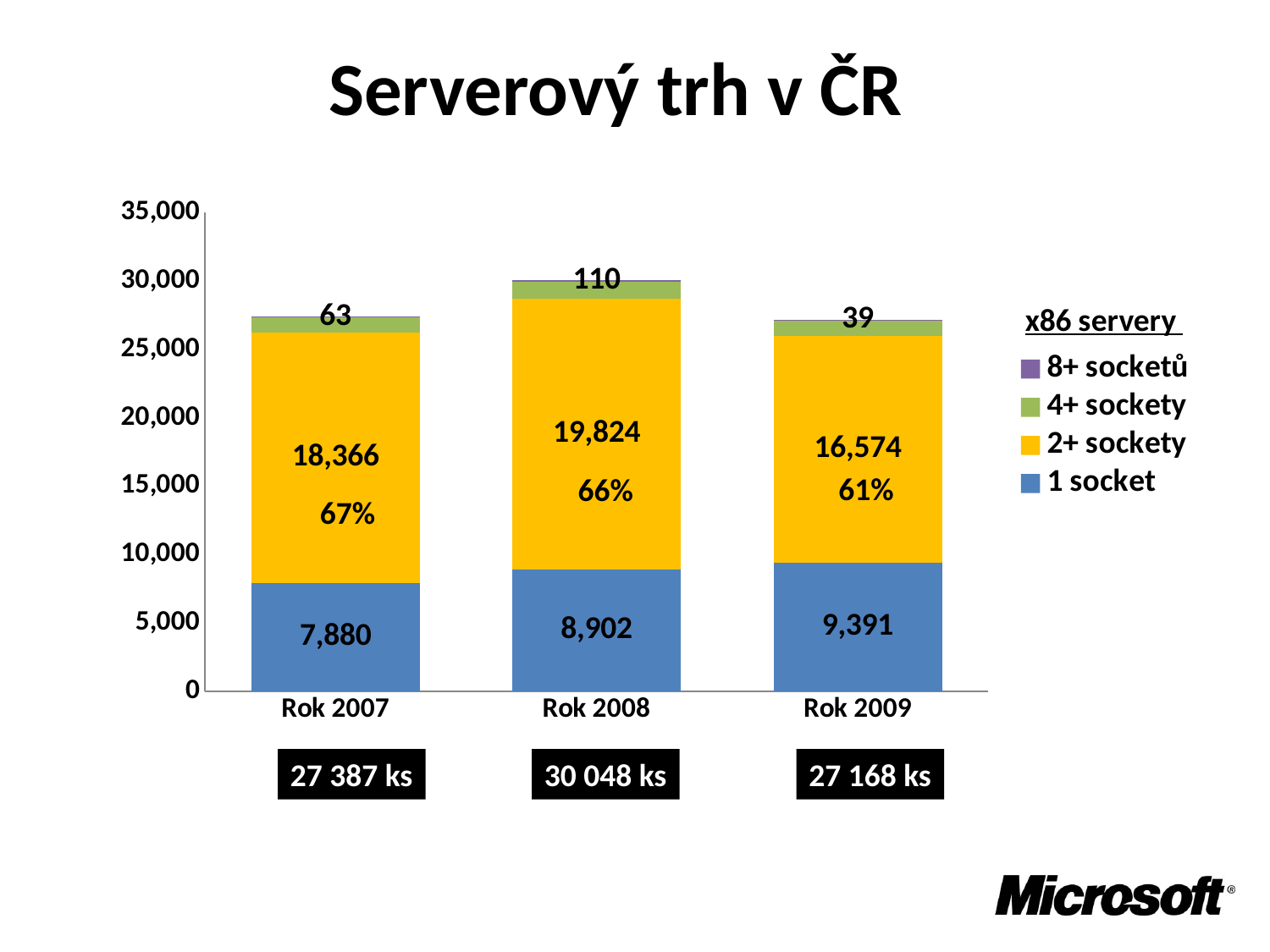
Which year has the lowest value for 2+ sockety? Rok 2009 What percentage is printed on the 2+ sockety segment for Rok 2009? 61% What kind of chart is shown on the slide? stacked bar chart How many years are shown on the x axis? 3 Is the total height of the Rok 2007 bar greater or less than 25,000? greater Which year has the highest value for 1 socket? Rok 2009 What is the value for 1 socket in Rok 2007? 7,880 What total is shown in the box below the Rok 2008 bar? 30 048 ks What is the value for 2+ sockety in Rok 2008? 19,824 How many series does the legend list? 4 What is the difference between the 1 socket values for Rok 2009 and Rok 2007? 1,511 Which is larger, the 2+ sockety value for Rok 2007 or for Rok 2009? Rok 2007